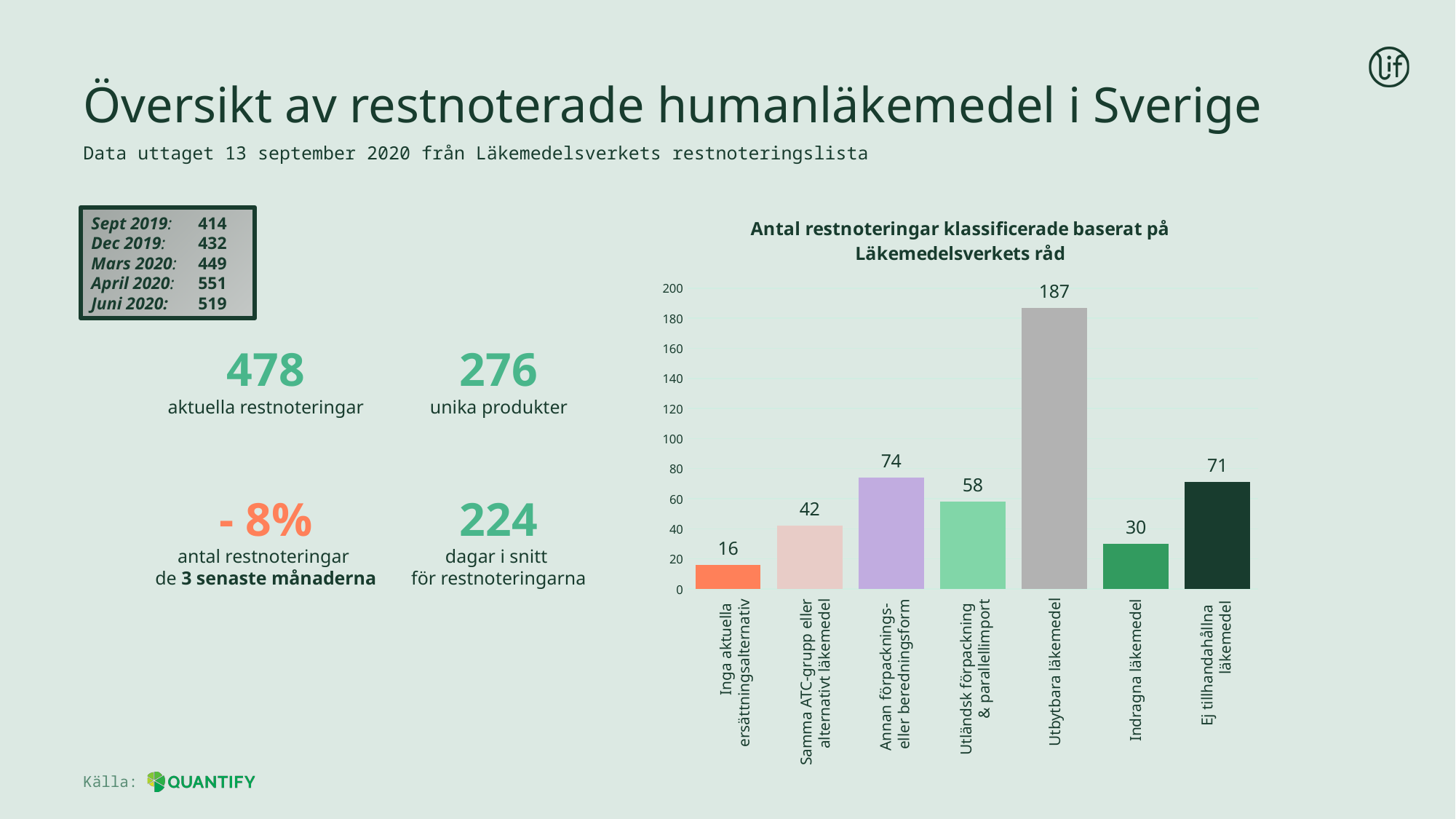
What is the title of the chart? Antal restnoteringar klassificerade baserat på Läkemedelsverkets råd What is the difference between Utbytbara läkemedel and Ej tillhandahållna läkemedel? 116 Is the value for Samma ATC-grupp eller alternativt läkemedel greater or less than 60? less Which category has the highest value? Utbytbara läkemedel What is the value for Utbytbara läkemedel? 187 What kind of chart is shown on the slide? bar chart What is the value for Indragna läkemedel? 30 Which is larger, Annan förpacknings- eller beredningsform or Utländsk förpackning & parallellimport? Annan förpacknings- eller beredningsform What is the difference between Annan förpacknings- eller beredningsform and Samma ATC-grupp eller alternativt läkemedel? 32 How many categories are shown in the chart? 7 Which category has the lowest value? Inga aktuella ersättningsalternativ What is the value for Inga aktuella ersättningsalternativ? 16